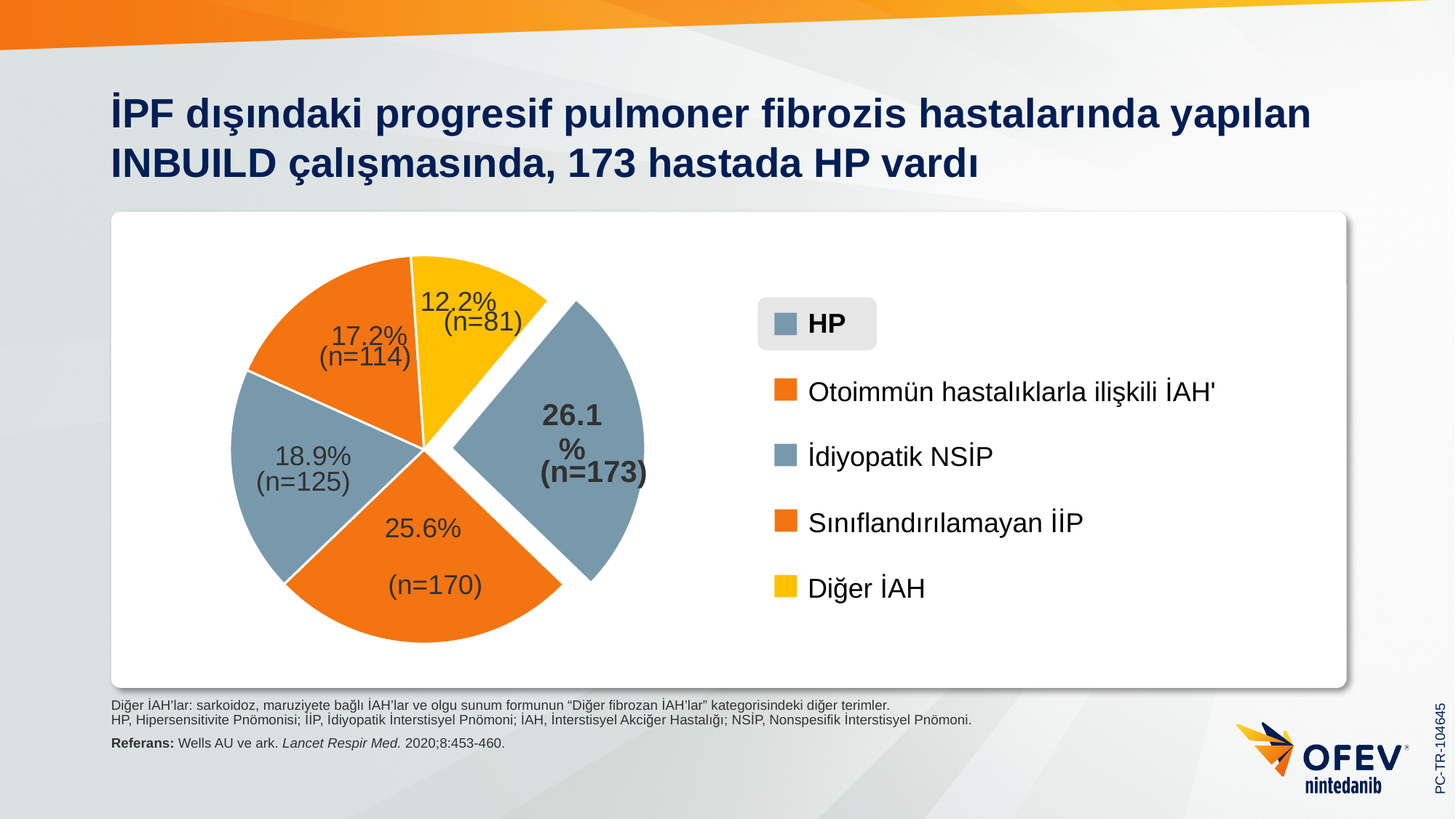
How many patients (n) are in the Diğer İAH slice? n=81 What is the difference in percentage points between the HP slice (26.1%) and the Otoimmün hastalıklarla ilişkili İAH slice (25.6%)? 0.5 percentage points What type of chart is shown on the slide? Pie chart What percentage of the pie chart does the HP slice represent? 26.1% Which slice is pulled out (exploded) from the rest of the pie chart? HP How many patients (n) are in the HP slice of the pie chart? n=173 What percentage is shown for the İdiyopatik NSİP slice? 18.9% Which has more patients: the İdiyopatik NSİP slice (n=125) or the Sınıflandırılamayan İİP slice (n=114)? İdiyopatik NSİP How many slices does the pie chart have? 5 Which category has the smallest share of the pie chart? Diğer İAH Which category has the largest share of the pie chart? HP What percentage is shown for the Diğer İAH slice? 12.2%